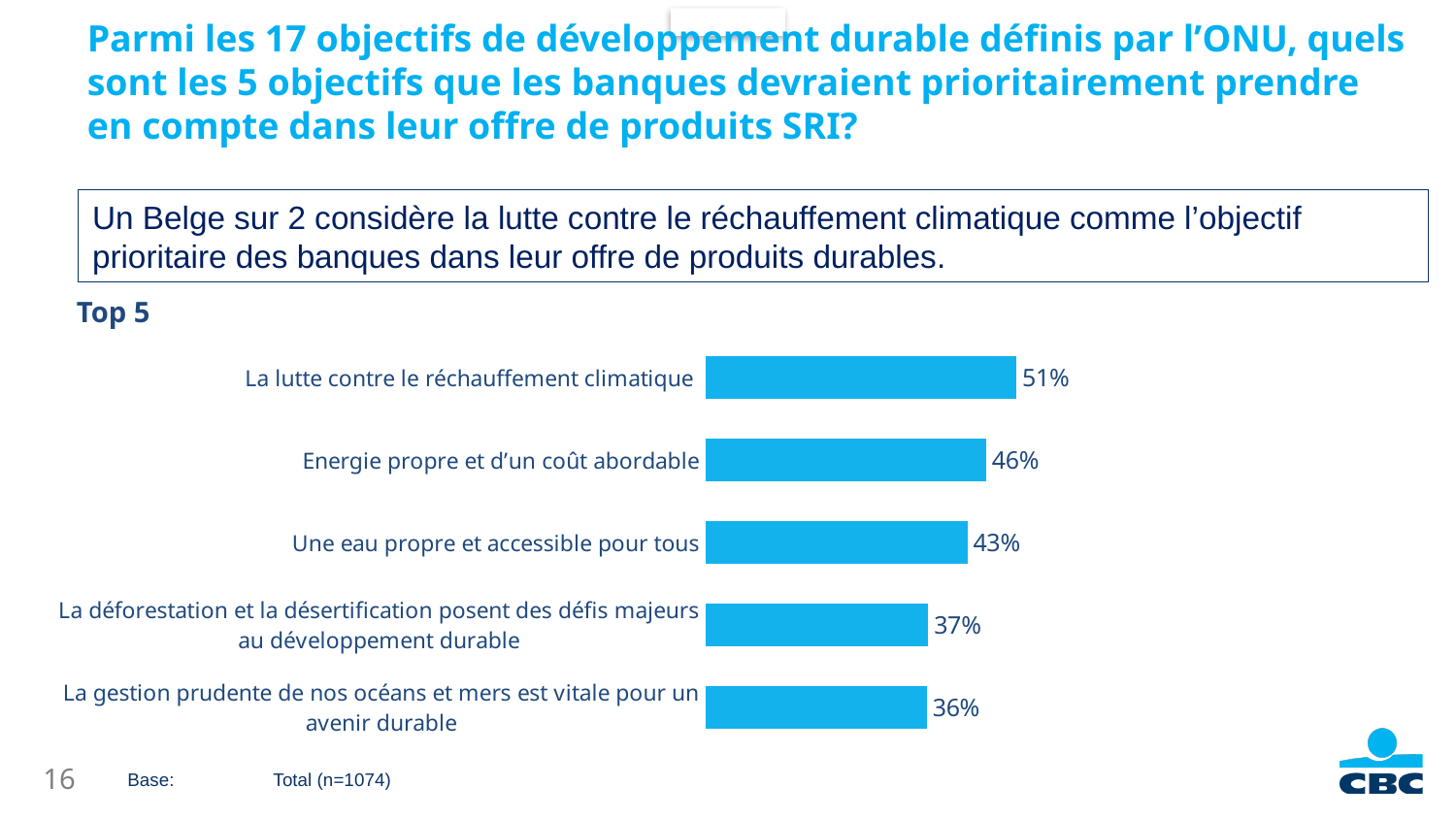
Which is larger: the value for "Energie propre et d’un coût abordable" or for "Une eau propre et accessible pour tous"? Energie propre et d’un coût abordable What is the difference between the values for "La lutte contre le réchauffement climatique" and "Energie propre et d’un coût abordable"? 5% What is the value for "Une eau propre et accessible pour tous"? 43% What is the difference between the values for "Une eau propre et accessible pour tous" and "La déforestation et la désertification posent des défis majeurs au développement durable"? 6% What is the title shown above the chart? Top 5 What is the value for "La gestion prudente de nos océans et mers est vitale pour un avenir durable"? 36% Which category has the lowest value? La gestion prudente de nos océans et mers est vitale pour un avenir durable What is the value for "La lutte contre le réchauffement climatique"? 51% What is the value for "Energie propre et d’un coût abordable"? 46% How many categories are shown in the chart? 5 Which category has the highest value? La lutte contre le réchauffement climatique What kind of chart is shown on the slide? Bar chart